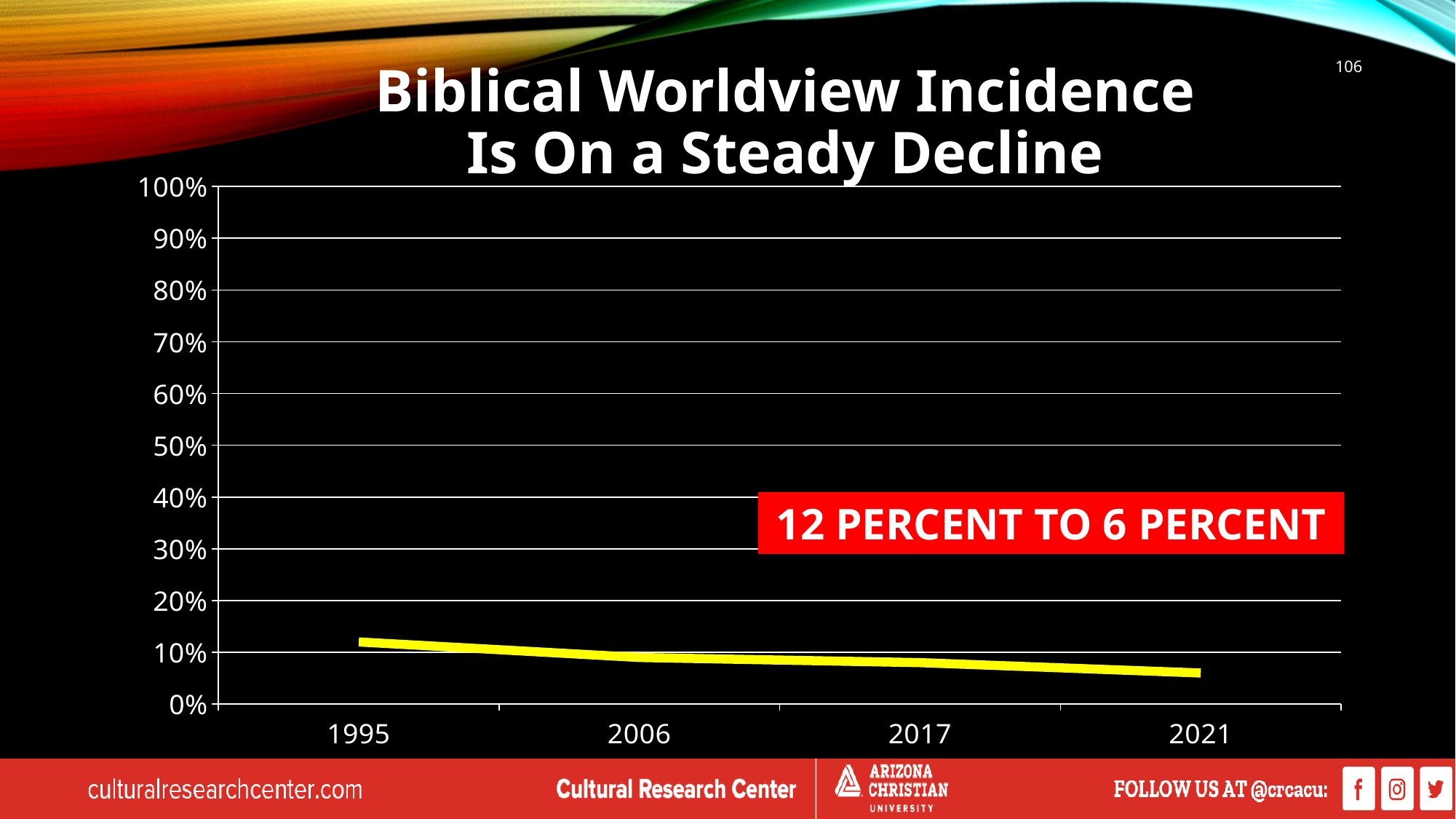
Is the value for 2021 greater or less than 10%? less How many years are plotted along the x axis? 4 Which is larger, the value for 1995 or the value for 2021? 1995 Is the value for 1995 greater or less than 20%? less What is the title of the chart? Biblical Worldview Incidence Is On a Steady Decline Which year has the lowest plotted value? 2021 Which year has the highest plotted value? 1995 What kind of chart is shown on the slide? line chart Is the value for 2017 greater or less than 10%? less Do the plotted values rise or fall from 1995 to 2021? fall What does the red callout box on the chart say? 12 PERCENT TO 6 PERCENT